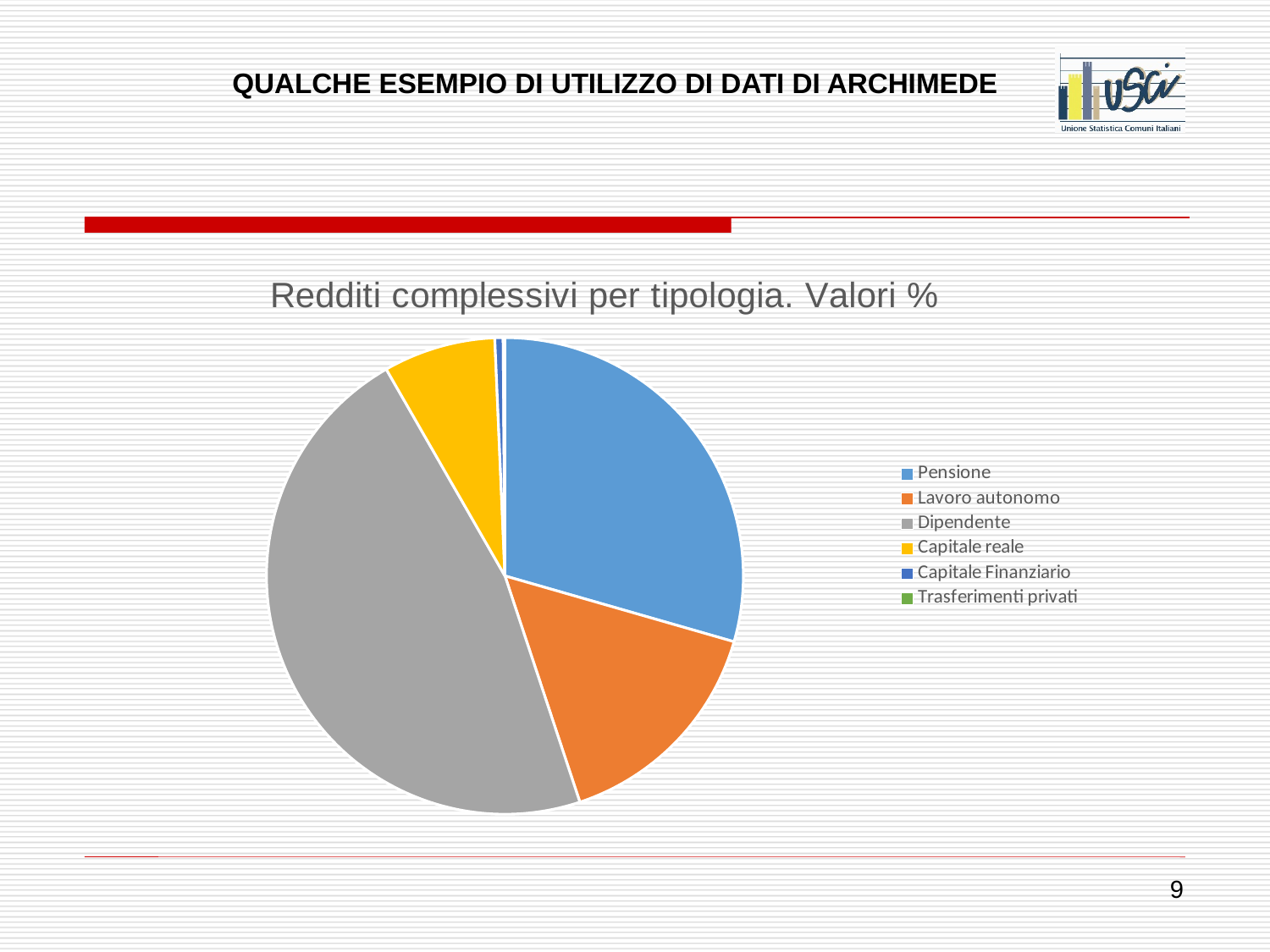
Which slice is larger, Capitale reale or Lavoro autonomo? Lavoro autonomo Which category is the second largest slice of the pie? Pensione What kind of chart is shown on the slide? pie chart Which slice is larger, Pensione or Lavoro autonomo? Pensione How many categories does the legend of the pie chart list? 6 Which category has the largest slice of the pie? Dipendente Which slice is larger, Dipendente or Pensione? Dipendente What is the title of the chart? Redditi complessivi per tipologia. Valori % Which colour represents Dipendente in the pie chart? grey